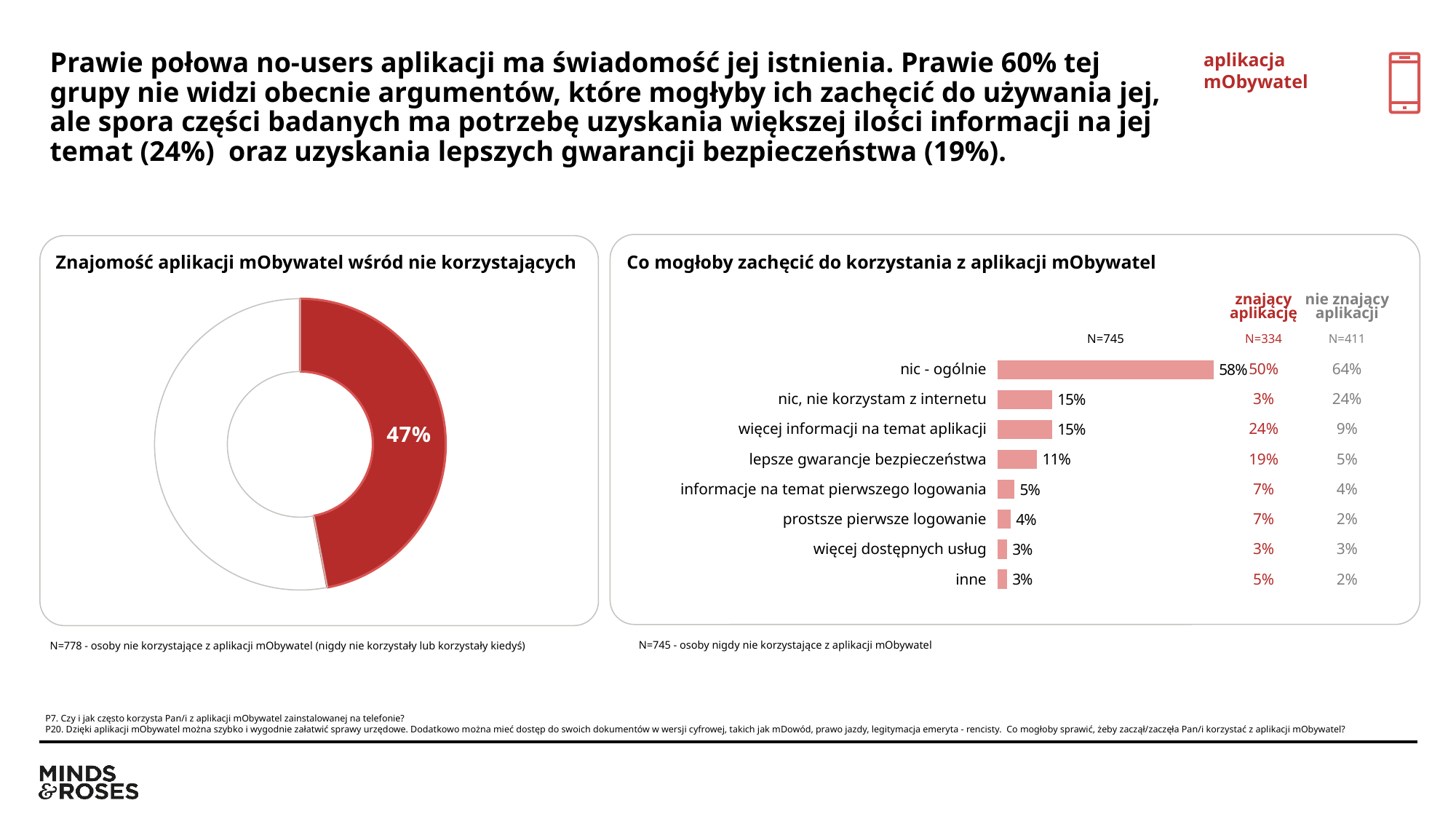
In the chart 'Co mogłoby zachęcić do korzystania z aplikacji mObywatel', what is the value for 'nic - ogólnie'? 58% What sample size (N) is shown above the bars in the chart 'Co mogłoby zachęcić do korzystania z aplikacji mObywatel'? N=745 In the chart 'Co mogłoby zachęcić do korzystania z aplikacji mObywatel', which category has the highest value? nic - ogólnie In the chart 'Co mogłoby zachęcić do korzystania z aplikacji mObywatel', what is the value for 'lepsze gwarancje bezpieczeństwa'? 11% What kind of chart is 'Znajomość aplikacji mObywatel wśród nie korzystających'? Donut (pie) chart In the chart 'Co mogłoby zachęcić do korzystania z aplikacji mObywatel', what is the difference between 'nic - ogólnie' and 'nic, nie korzystam z internetu'? 43 percentage points In the chart 'Znajomość aplikacji mObywatel wśród nie korzystających', what percentage is shown on the highlighted slice? 47% In the chart 'Co mogłoby zachęcić do korzystania z aplikacji mObywatel', what is the value for 'nic - ogólnie' in the 'nie znający aplikacji' column? 64% What kind of chart is 'Co mogłoby zachęcić do korzystania z aplikacji mObywatel'? Bar chart In the chart 'Co mogłoby zachęcić do korzystania z aplikacji mObywatel', what is the value for 'więcej informacji na temat aplikacji' in the 'znający aplikację' column? 24% In the chart 'Co mogłoby zachęcić do korzystania z aplikacji mObywatel', how many categories are plotted? 8 In the chart 'Co mogłoby zachęcić do korzystania z aplikacji mObywatel', which is larger: 'informacje na temat pierwszego logowania' or 'prostsze pierwsze logowanie'? informacje na temat pierwszego logowania